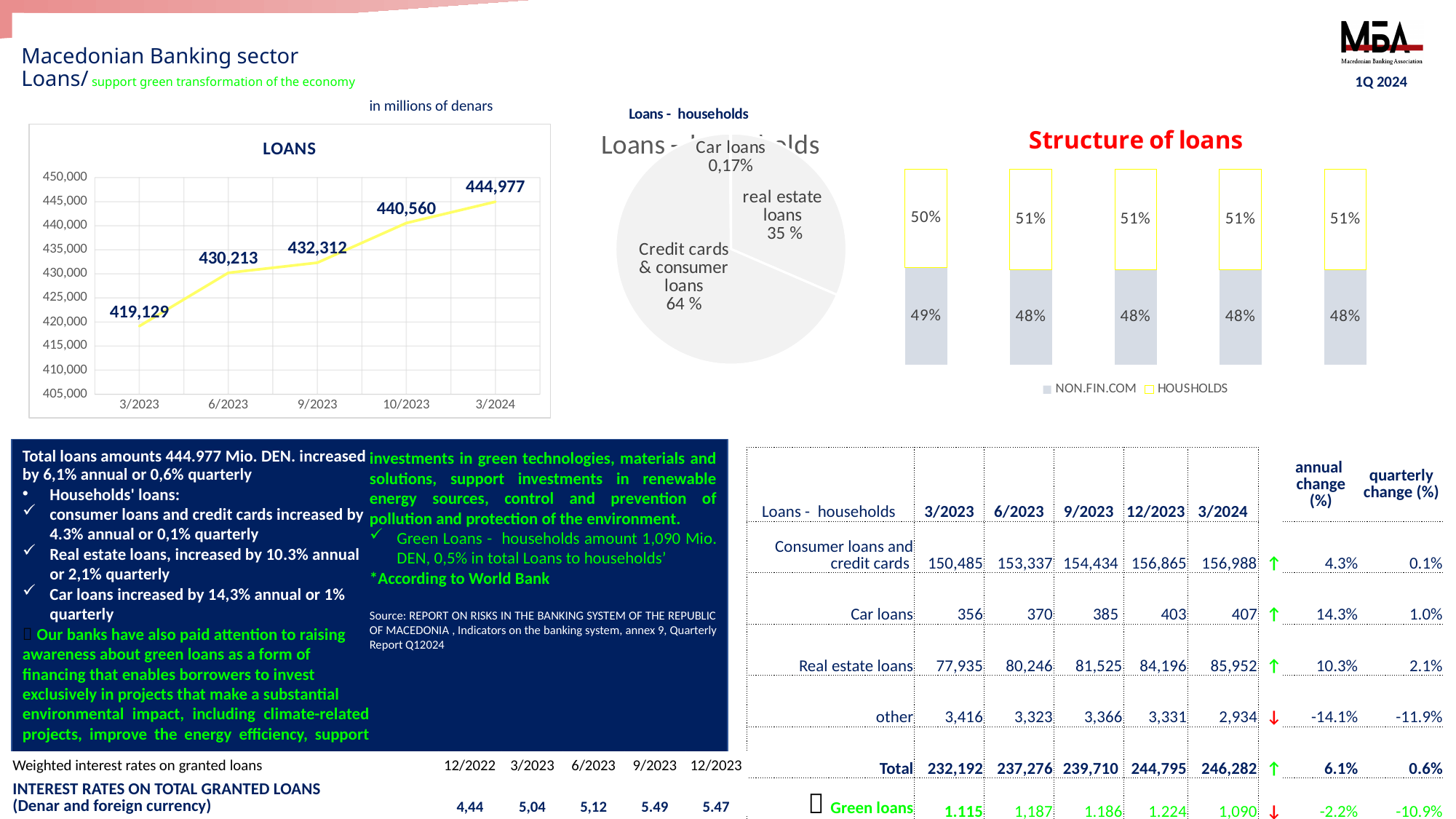
In the LOANS chart, what is the difference between the values for 3/2024 and 3/2023? 25,848 In the LOANS chart, which period has the lowest value? 3/2023 In the Structure of loans chart, what is the NON.FIN.COM value in the first (leftmost) bar? 49% In the LOANS chart, which period has the highest value? 3/2024 In the LOANS chart, do the values rise or fall from 3/2023 to 3/2024? rise How many data points are plotted in the LOANS chart? 5 In the LOANS chart, what is the value for 6/2023? 430,213 How many series does the legend of the Structure of loans chart list? 2 In the LOANS chart, what is the value for 3/2024? 444,977 In the Loans - households pie chart, which slice is the largest? Credit cards & consumer loans What kind of chart is the LOANS chart? line chart In the Loans - households pie chart, what share do real estate loans have? 35 %